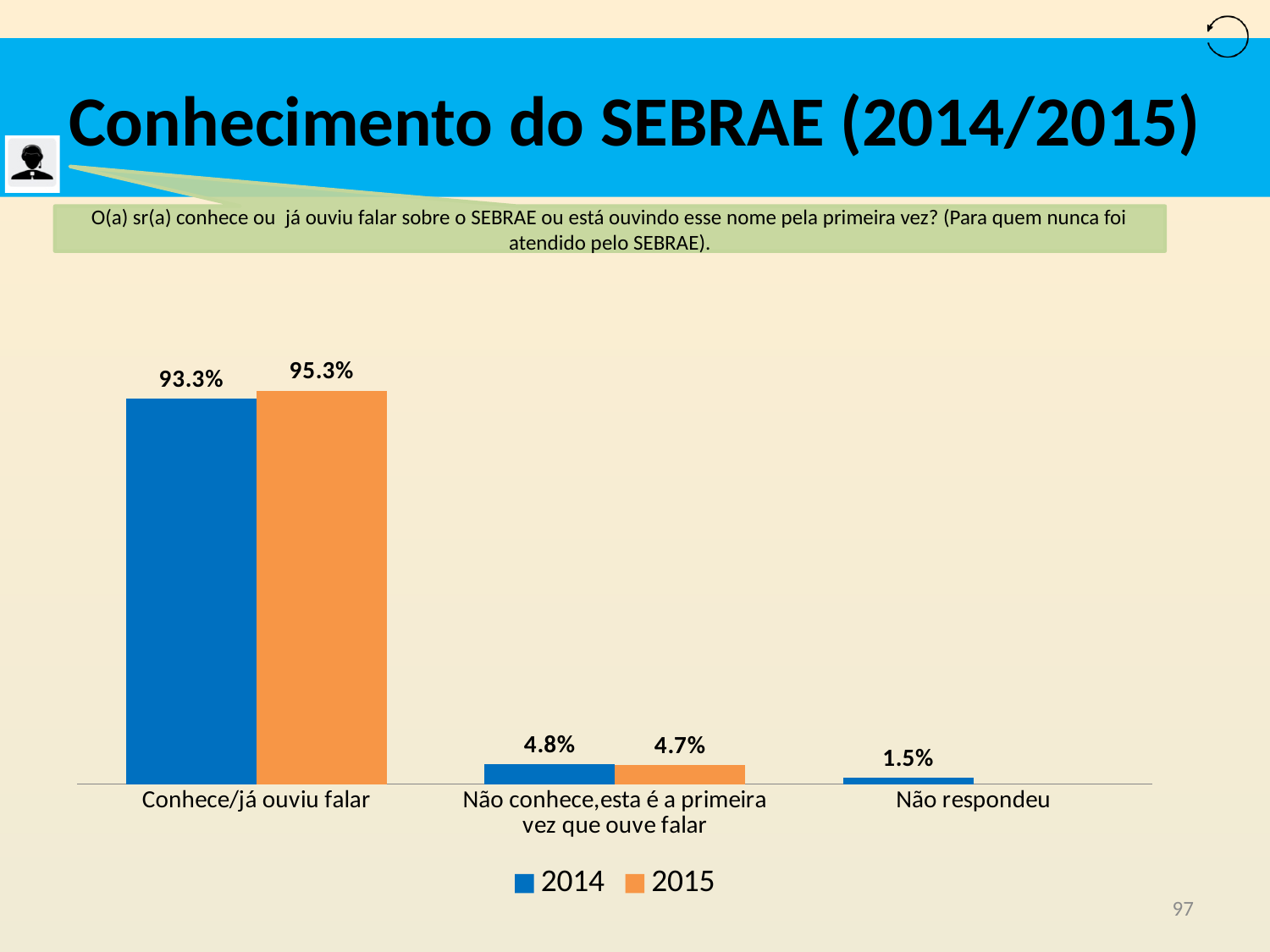
How many categories are shown on the x axis? 3 What is the 2014 value for "Não respondeu"? 1.5% What is the 2014 value for "Conhece/já ouviu falar"? 93.3% Which category has the highest value in the 2015 series? Conhece/já ouviu falar What is the 2015 value for "Conhece/já ouviu falar"? 95.3% Which category has the lowest value in the 2014 series? Não respondeu What is the 2015 value for "Não conhece, esta é a primeira vez que ouve falar"? 4.7% What kind of chart is shown on the slide? Bar chart What is the 2014 value for "Não conhece, esta é a primeira vez que ouve falar"? 4.8% What is the difference between the 2015 and 2014 values for "Conhece/já ouviu falar"? 2.0% For "Conhece/já ouviu falar", which year has the larger value, 2014 or 2015? 2015 How many series does the legend list? 2